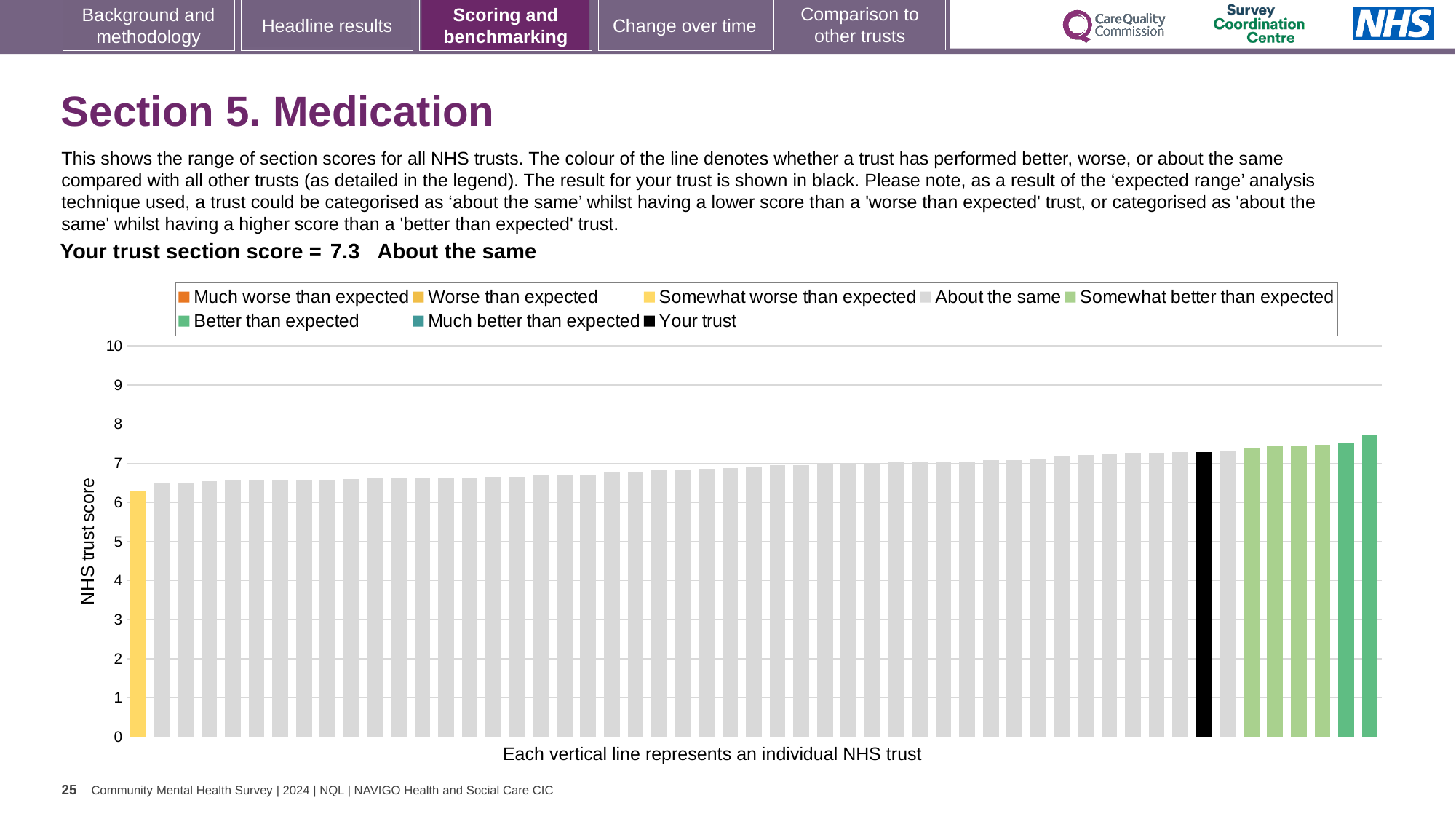
What is your trust's section score for Section 5. Medication? 7.3 How many entries does the chart legend list? 8 Is the score of the highest (rightmost) trust greater or less than 7? greater What is the label on the vertical axis of the chart? NHS trust score Is the score of the highest (rightmost) trust greater or less than 8? less What colour is the bar representing your trust? Black Do the trust scores rise or fall from left to right along the x axis? Rise Is the score of the lowest (leftmost) trust greater or less than 6? greater Which is larger: your trust's score or the score of the leftmost (yellow) trust? Your trust's score How is your trust's score categorised compared with other trusts? About the same What kind of chart is shown on the slide? Bar chart